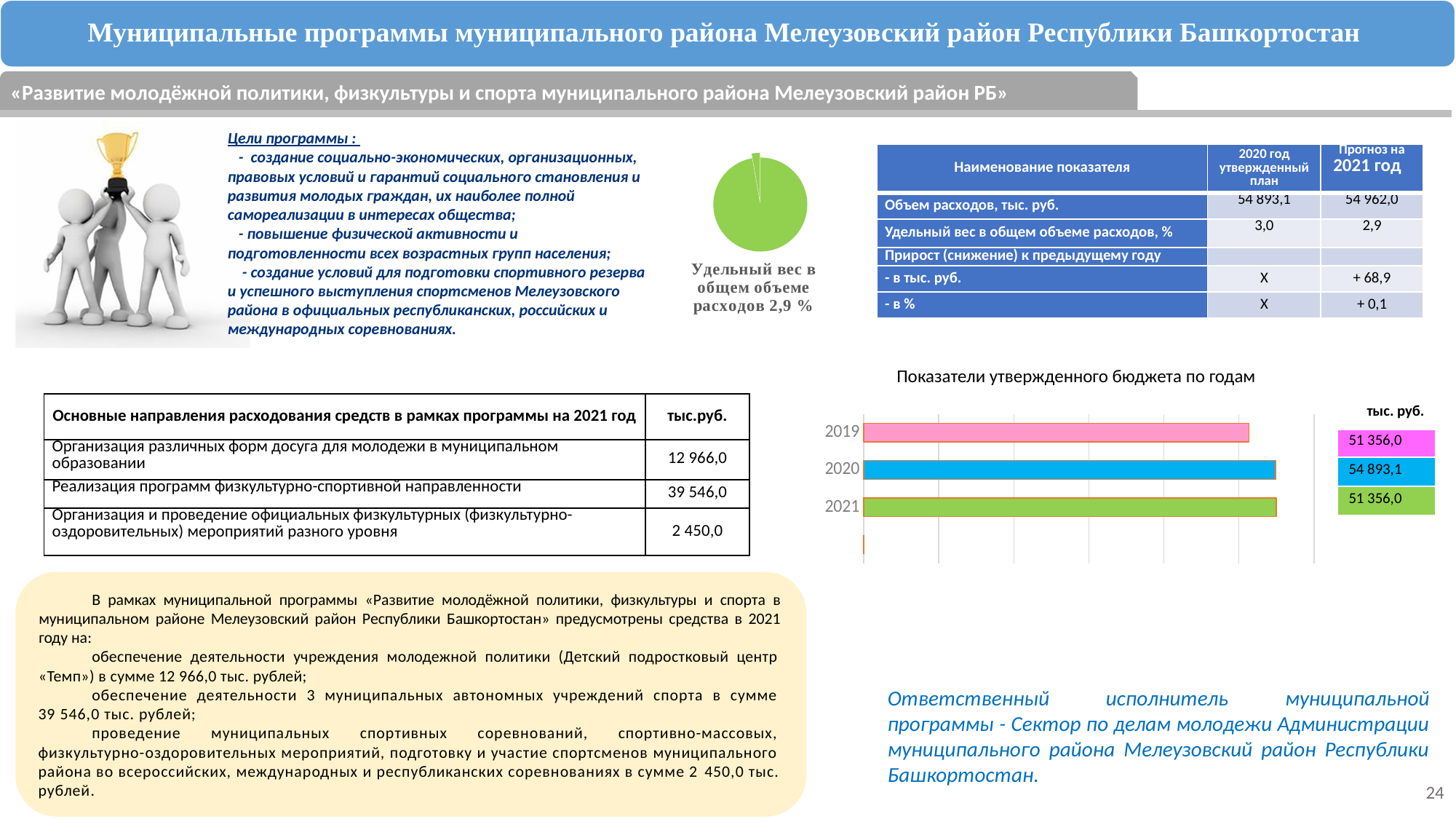
In the chart «Показатели утвержденного бюджета по годам», what is the difference between the values for 2020 and 2019? 3 537,1 What kind of chart is the chart titled «Показатели утвержденного бюджета по годам»? bar chart What kind of chart is the small green chart next to the program goals text? pie chart In the pie chart next to the program goals, what share of total expenditure does the program represent according to its caption? 2,9 % What colour is the bar for 2021 in the chart «Показатели утвержденного бюджета по годам»? green How many years (bars) are shown in the chart «Показатели утвержденного бюджета по годам»? 3 In the chart «Показатели утвержденного бюджета по годам», what is the value for 2020? 54 893,1 In the chart «Показатели утвержденного бюджета по годам», what is the value for 2019? 51 356,0 What unit is indicated above the value labels of the chart «Показатели утвержденного бюджета по годам»? тыс. руб. In the chart «Показатели утвержденного бюджета по годам», which is larger, the value for 2019 or the value for 2020? 2020